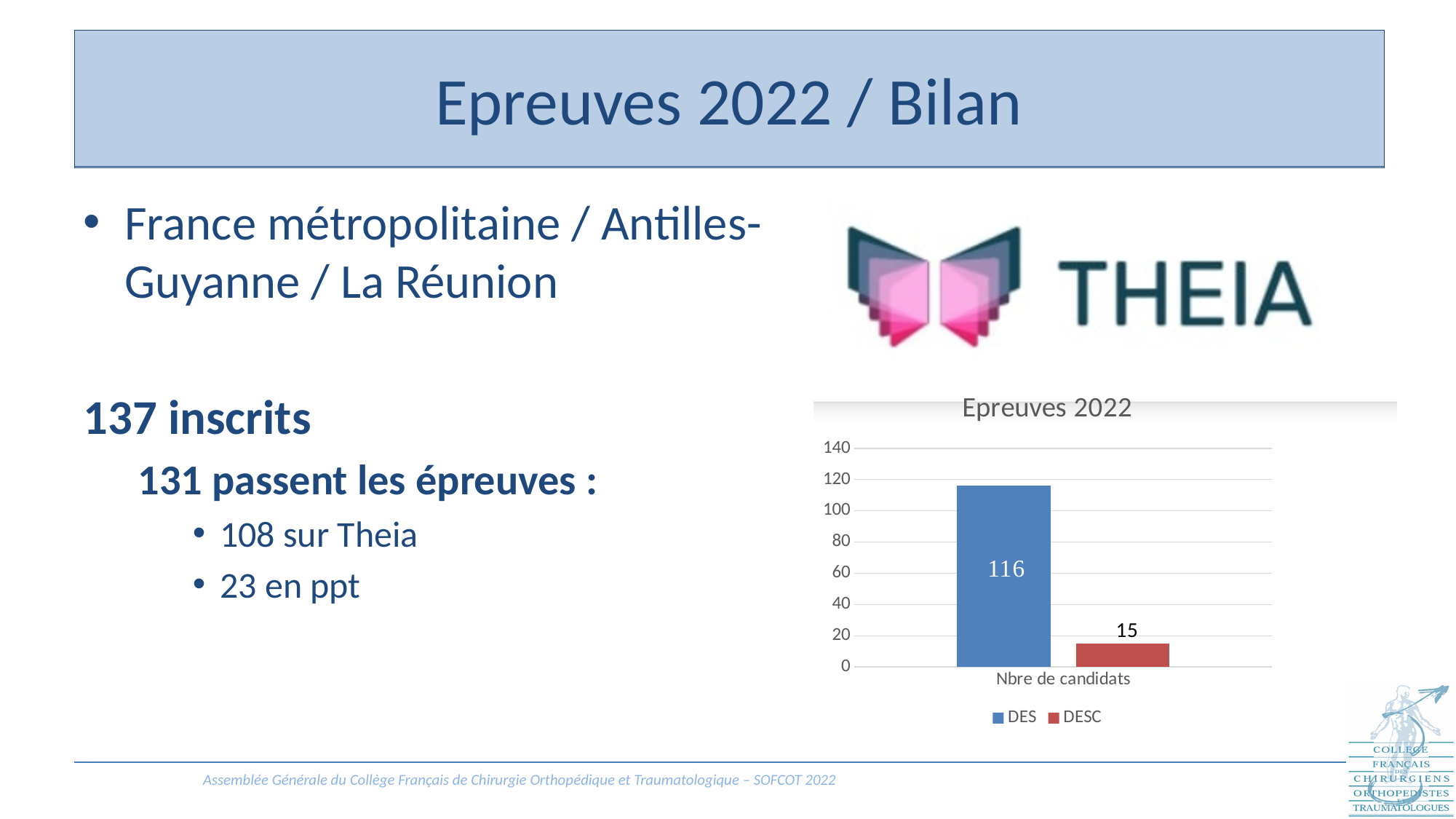
What is the category label on the x axis of the Epreuves 2022 chart? Nbre de candidats What is the value for DESC in the Epreuves 2022 chart? 15 Which series has the highest value in the Epreuves 2022 chart? DES Is the value for DES greater or less than 100 in the Epreuves 2022 chart? greater How many series does the legend of the Epreuves 2022 chart list? 2 What kind of chart is the Epreuves 2022 chart? bar chart Which is larger in the Epreuves 2022 chart, DES or DESC? DES Which series has the lowest value in the Epreuves 2022 chart? DESC Is the value for DESC greater or less than 20 in the Epreuves 2022 chart? less What is the difference between the DES and DESC values in the Epreuves 2022 chart? 101 What is the value for DES in the Epreuves 2022 chart? 116 What is the title of the chart on the slide? Epreuves 2022